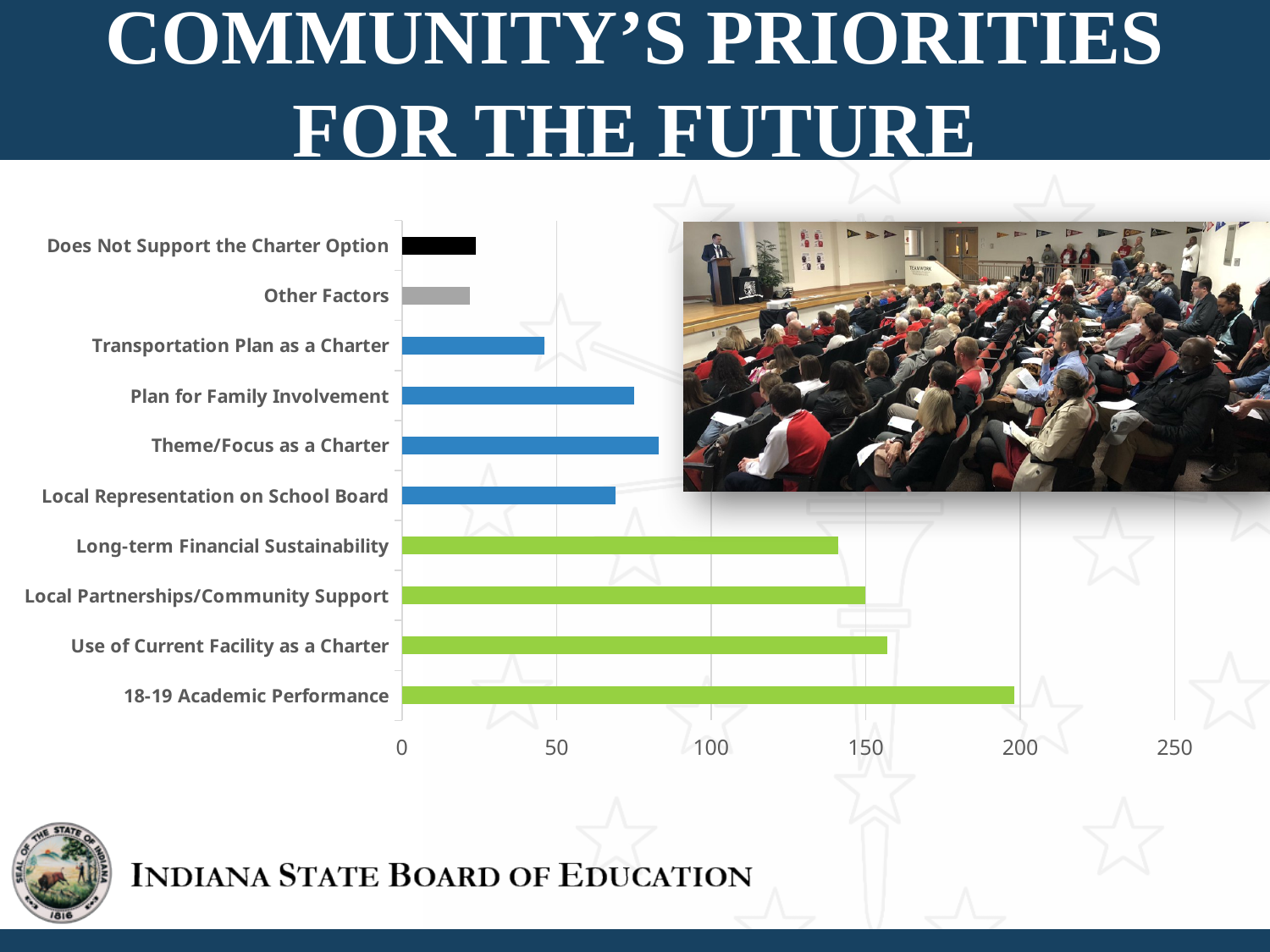
What colour is the bar for Does Not Support the Charter Option? black Is the value for Transportation Plan as a Charter greater or less than 50? less Which is larger, the value for Local Partnerships/Community Support or the value for Local Representation on School Board? Local Partnerships/Community Support Which is larger, the value for Plan for Family Involvement or the value for Transportation Plan as a Charter? Plan for Family Involvement Is the value for 18-19 Academic Performance greater or less than 150? greater Is the value for Theme/Focus as a Charter greater or less than 100? less Which category has the highest value in the chart? 18-19 Academic Performance How many categories are plotted in the bar chart? 10 What kind of chart is shown on the slide? bar chart What is the highest value shown on the horizontal axis of the chart? 250